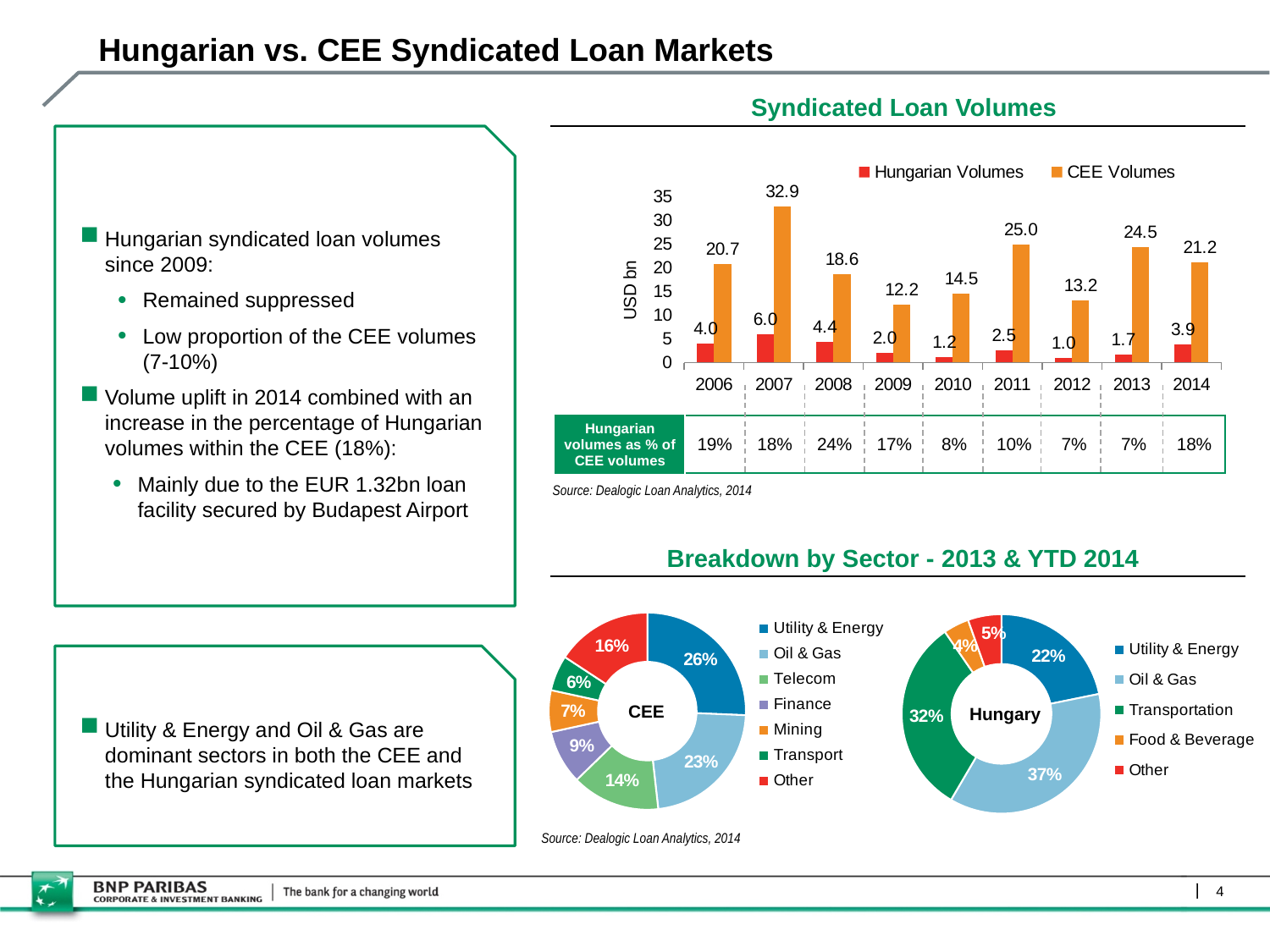
In the Syndicated Loan Volumes chart, is the CEE Volumes value for 2011 larger or smaller than the value for 2013? larger How many years are shown on the x axis of the Syndicated Loan Volumes chart? 9 In the Syndicated Loan Volumes chart, which year has the lowest Hungarian Volumes? 2012 In the Hungary donut chart under Breakdown by Sector, which sector has the largest share? Oil & Gas In the Syndicated Loan Volumes chart, which year has the highest CEE Volumes? 2007 How many sectors does the legend of the Hungary donut chart list? 5 In the CEE donut chart under Breakdown by Sector, what share does Oil & Gas have? 23% What kind of chart is the Syndicated Loan Volumes chart? bar chart In the Syndicated Loan Volumes chart, what is the CEE Volumes value for 2007? 32.9 In the Syndicated Loan Volumes chart, what is the difference between CEE Volumes and Hungarian Volumes in 2014? 17.3 In the Syndicated Loan Volumes chart, what is the Hungarian Volumes value for 2012? 1.0 How many series does the legend of the Syndicated Loan Volumes chart list? 2